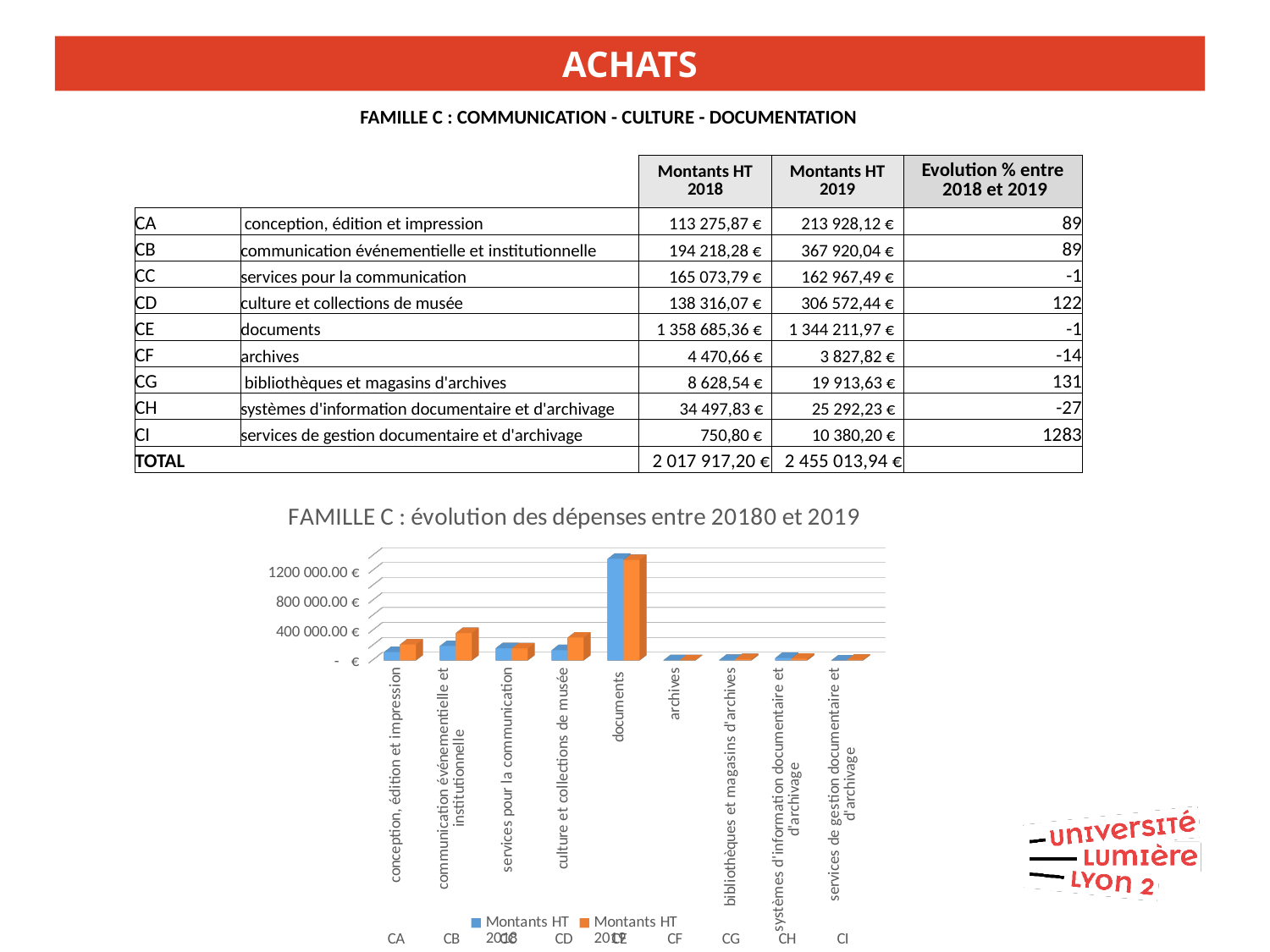
For communication événementielle et institutionnelle, which is larger: Montants HT 2018 or Montants HT 2019? Montants HT 2019 How many categories are plotted along the x axis of the chart? 9 Is the Montants HT 2018 value for documents greater or less than 1200 000.00 €? greater What is the difference between Montants HT 2019 and Montants HT 2018 for conception, édition et impression? 100 652,25 € Is the Montants HT 2019 value for culture et collections de musée greater or less than 400 000.00 €? less Which colour represents the Montants HT 2019 series in the chart? orange What is the Montants HT 2019 value for culture et collections de musée? 306 572,44 € What kind of chart is shown on the slide? bar chart What is the title of the chart? FAMILLE C : évolution des dépenses entre 20180 et 2019 What is the Montants HT 2018 value for documents? 1 358 685,36 € How many series does the chart legend list? 2 Which category has the highest bar for Montants HT 2018? documents (CE)